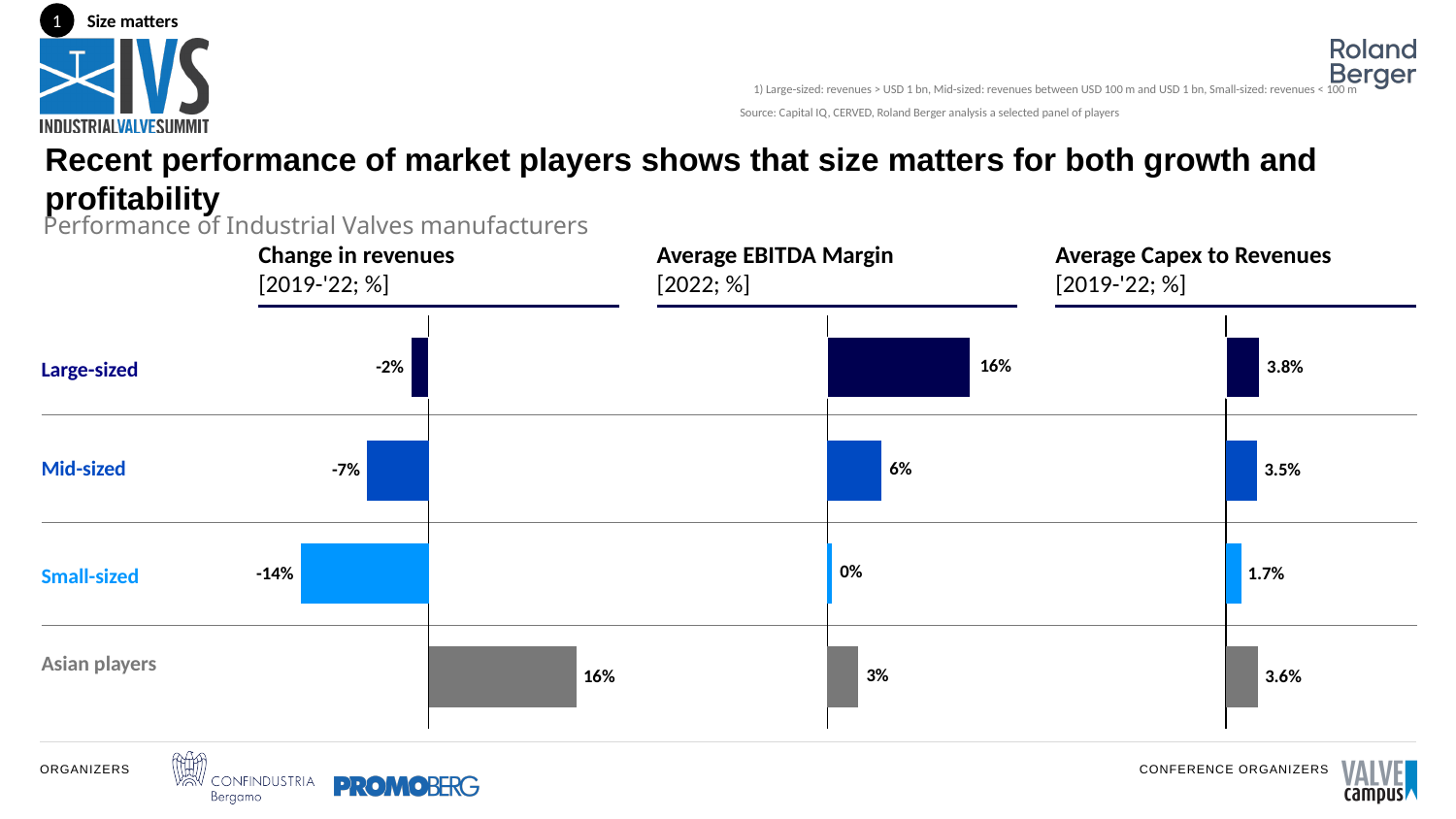
What time period is shown in the title of the 'Average EBITDA Margin' chart? 2022 How many categories are shown in the 'Average EBITDA Margin' chart? 4 In the 'Change in revenues' chart, which category has the highest value? Asian players In the 'Average EBITDA Margin' chart, what is the difference between the Large-sized and Mid-sized values? 10% In the 'Average Capex to Revenues' chart, which is larger: the value for Large-sized or for Asian players? Large-sized In the 'Change in revenues' chart, what is the value for Asian players? 16% In the 'Change in revenues' chart, what is the value for Small-sized players? -14% In the 'Average EBITDA Margin' chart, what is the value for Small-sized players? 0% In the 'Average Capex to Revenues' chart, what is the value for Mid-sized players? 3.5% In the 'Average Capex to Revenues' chart, which category has the lowest value? Small-sized What kind of chart is the 'Change in revenues' chart? Bar chart In the 'Average EBITDA Margin' chart, what is the value for Large-sized players? 16%